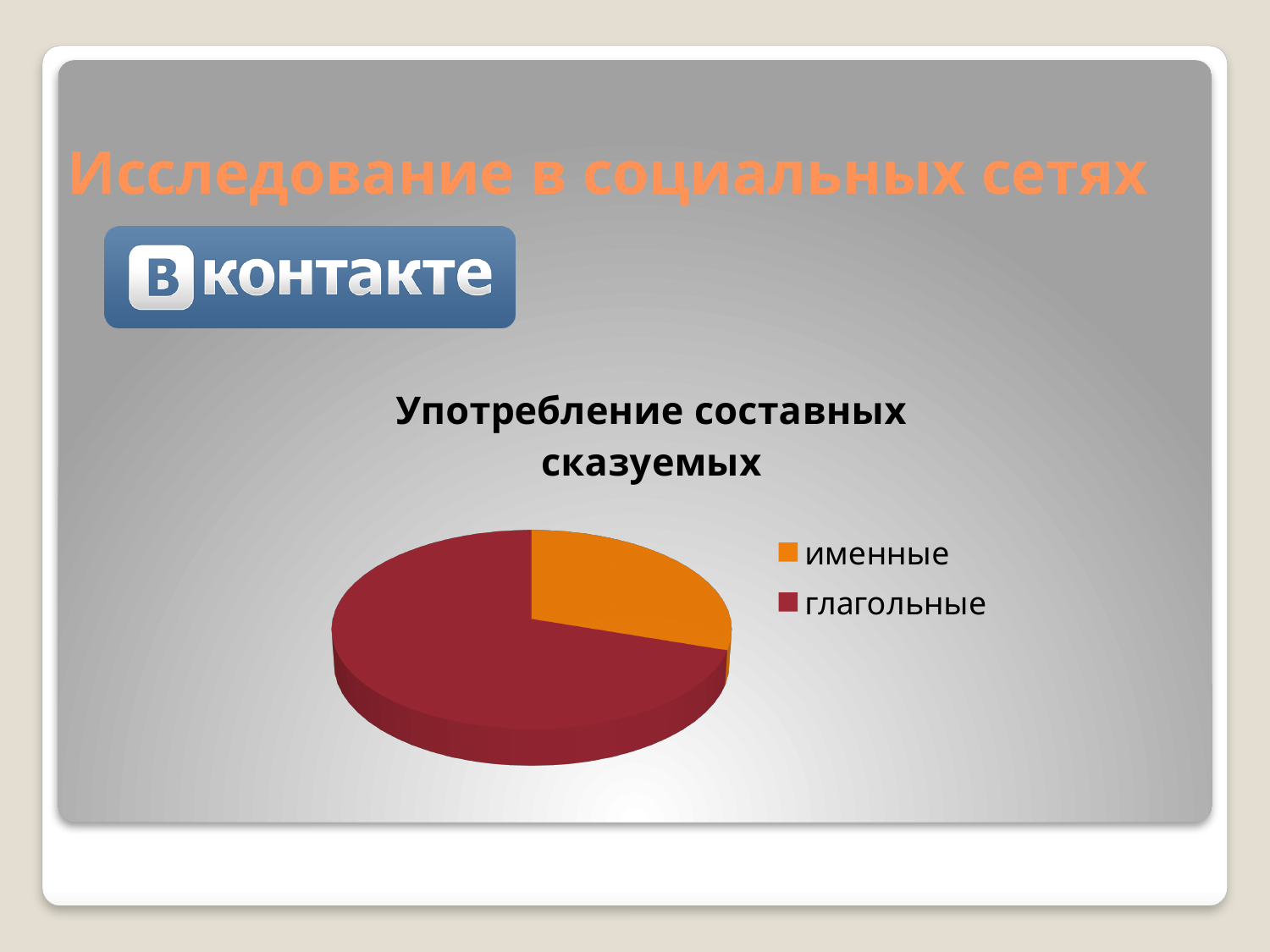
Which colour represents the category именные in the chart? orange Which category has the smallest slice of the pie? именные How many slices does the pie chart have? 2 What is the title of the chart? Употребление составных сказуемых How many entries does the legend list? 2 Which category has the largest slice of the pie? глагольные Which slice is larger, именные or глагольные? глагольные What kind of chart is shown on the slide? pie chart